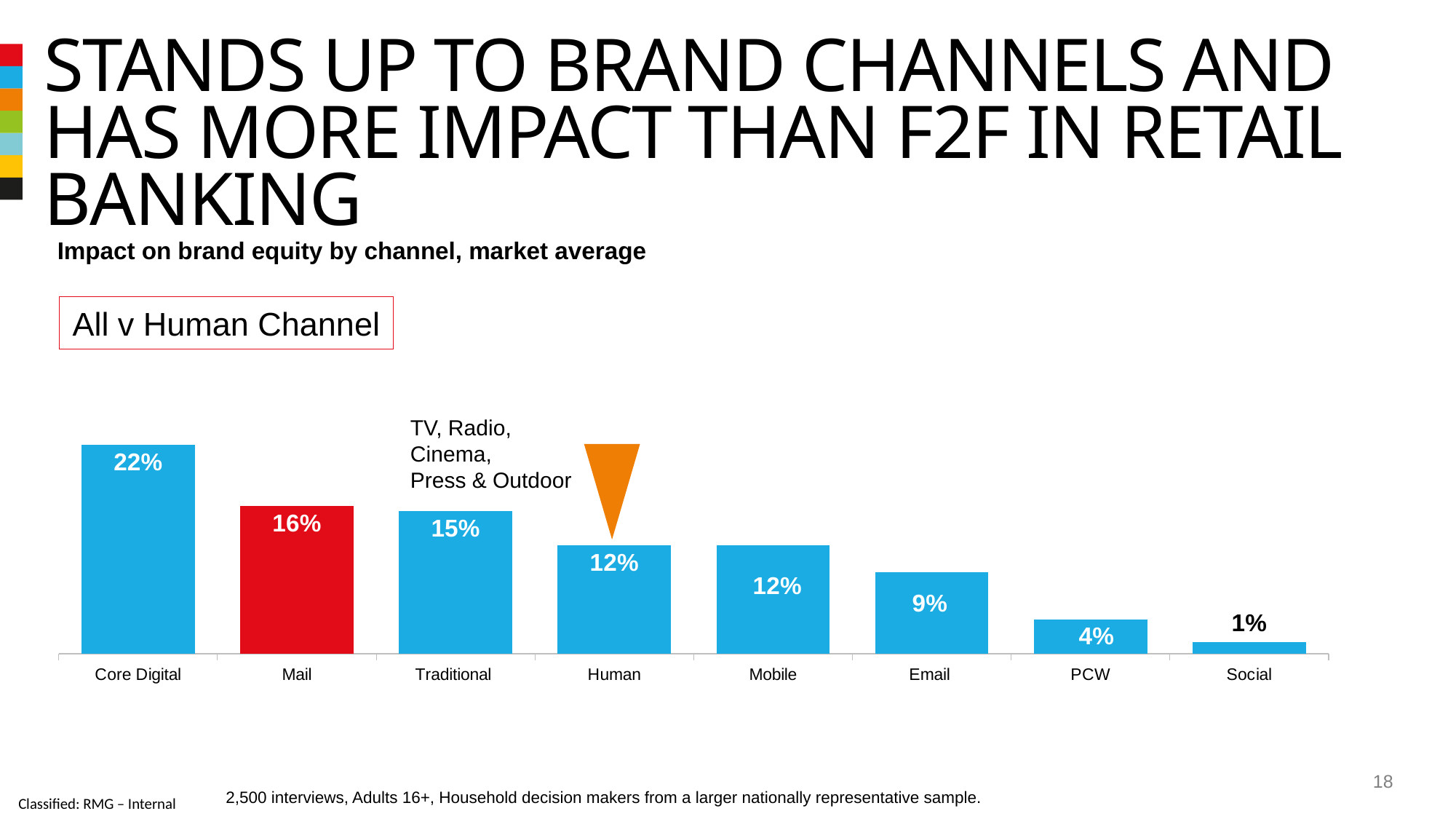
Which channel has the highest impact on brand equity? Core Digital What is the value for Core Digital? 22% Which is larger, the value for Traditional or the value for Mobile? Traditional What is the value for Social? 1% What is the difference between the values for Mail and PCW? 12% What is the value for Mail? 16% How many channels are shown in the chart? 8 Which bar is coloured red rather than blue? Mail What kind of chart is shown on the slide? Bar chart Which channel has the lowest impact on brand equity? Social What is the difference between the values for Core Digital and Human? 10% What is the value for Email? 9%